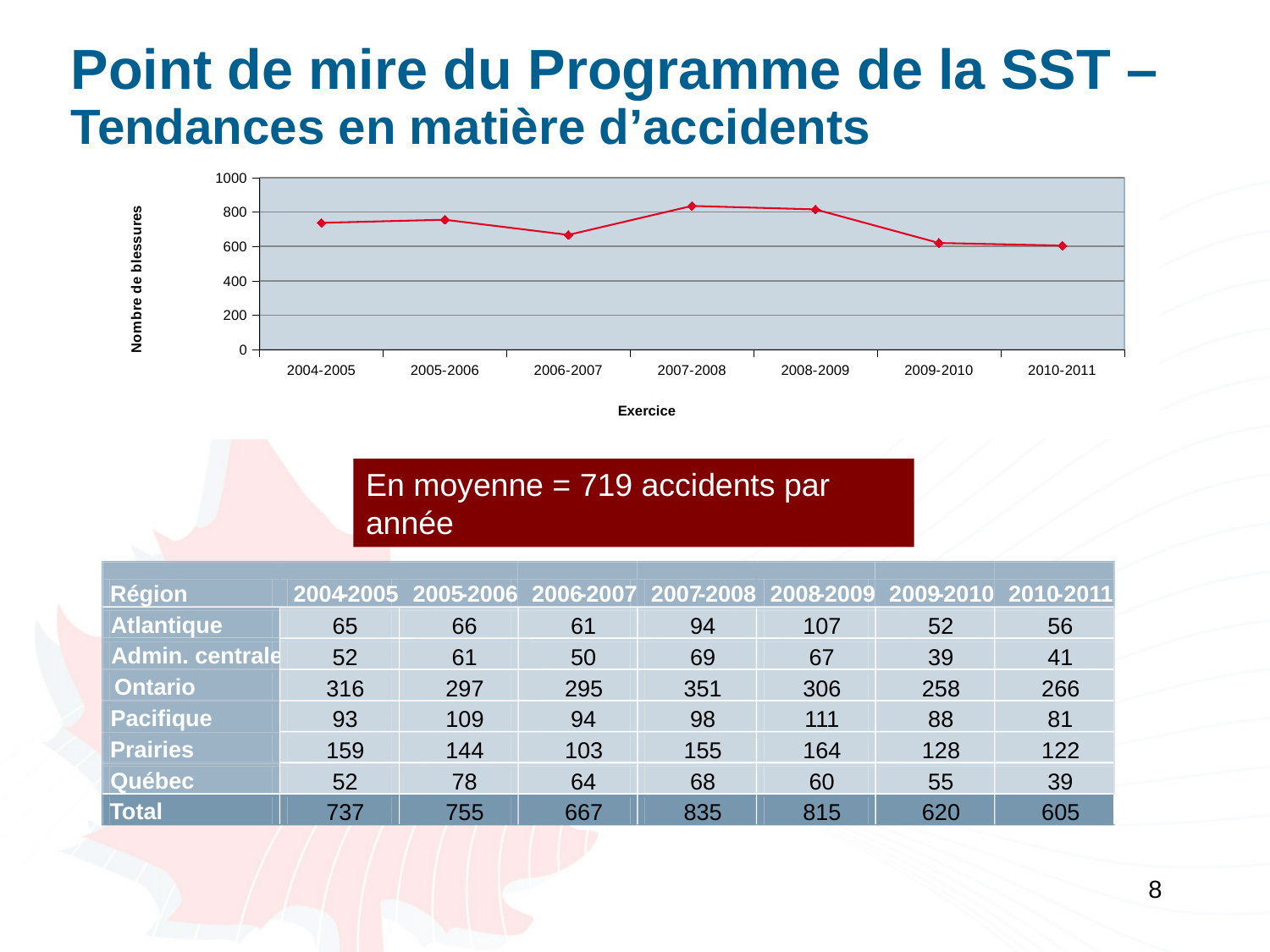
Using the totals shown on the slide, what is the difference between the values for 2004-2005 and 2006-2007? 70 Is the value plotted for 2004-2005 greater or less than 600? greater Which is larger on the chart, the value for 2007-2008 or the value for 2009-2010? 2007-2008 Is the value plotted for 2006-2007 greater or less than 800? less What is the title of the chart's horizontal axis? Exercice How many fiscal years (points) are plotted on the chart? 7 Which is larger on the chart, the value for 2004-2005 or the value for 2006-2007? 2004-2005 What kind of chart is shown on the slide? line chart Is the value plotted for 2010-2011 greater or less than 800? less According to the total row shown on the slide, what is the number of injuries plotted for 2007-2008? 835 Do the plotted values rise or fall from 2008-2009 to 2010-2011? fall What is the title of the chart's vertical axis? Nombre de blessures